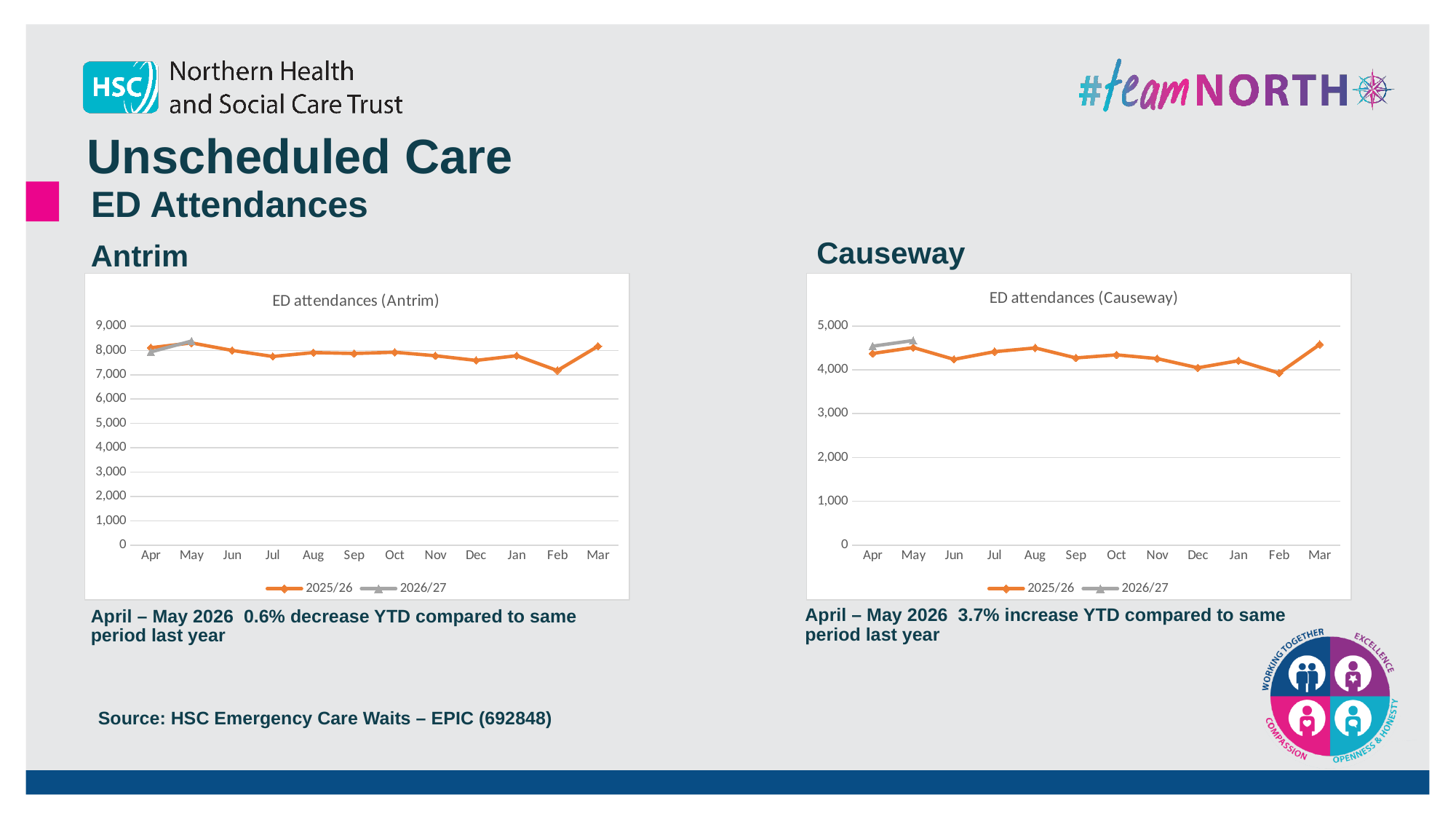
How many series does the legend of the ED attendances (Causeway) chart list? 2 How many months are shown on the x axis of the ED attendances (Antrim) chart? 12 What kind of chart is the ED attendances (Antrim) chart? line chart In the ED attendances (Causeway) chart, which month has the lowest 2025/26 value? Feb In the ED attendances (Antrim) chart, is the 2025/26 value for Feb greater or less than 8,000? less In the ED attendances (Antrim) chart, which is larger for 2025/26: Feb or Mar? Mar In the ED attendances (Antrim) chart, which month has the lowest 2025/26 value? Feb In the ED attendances (Causeway) chart, is the 2025/26 value for Jun greater or less than 3,000? greater In the ED attendances (Causeway) chart, is the 2025/26 value for Aug greater or less than 4,000? greater In the ED attendances (Causeway) chart, does the 2025/26 line rise or fall from Feb to Mar? rise What are the two series named in the legend of the ED attendances (Antrim) chart? 2025/26 and 2026/27